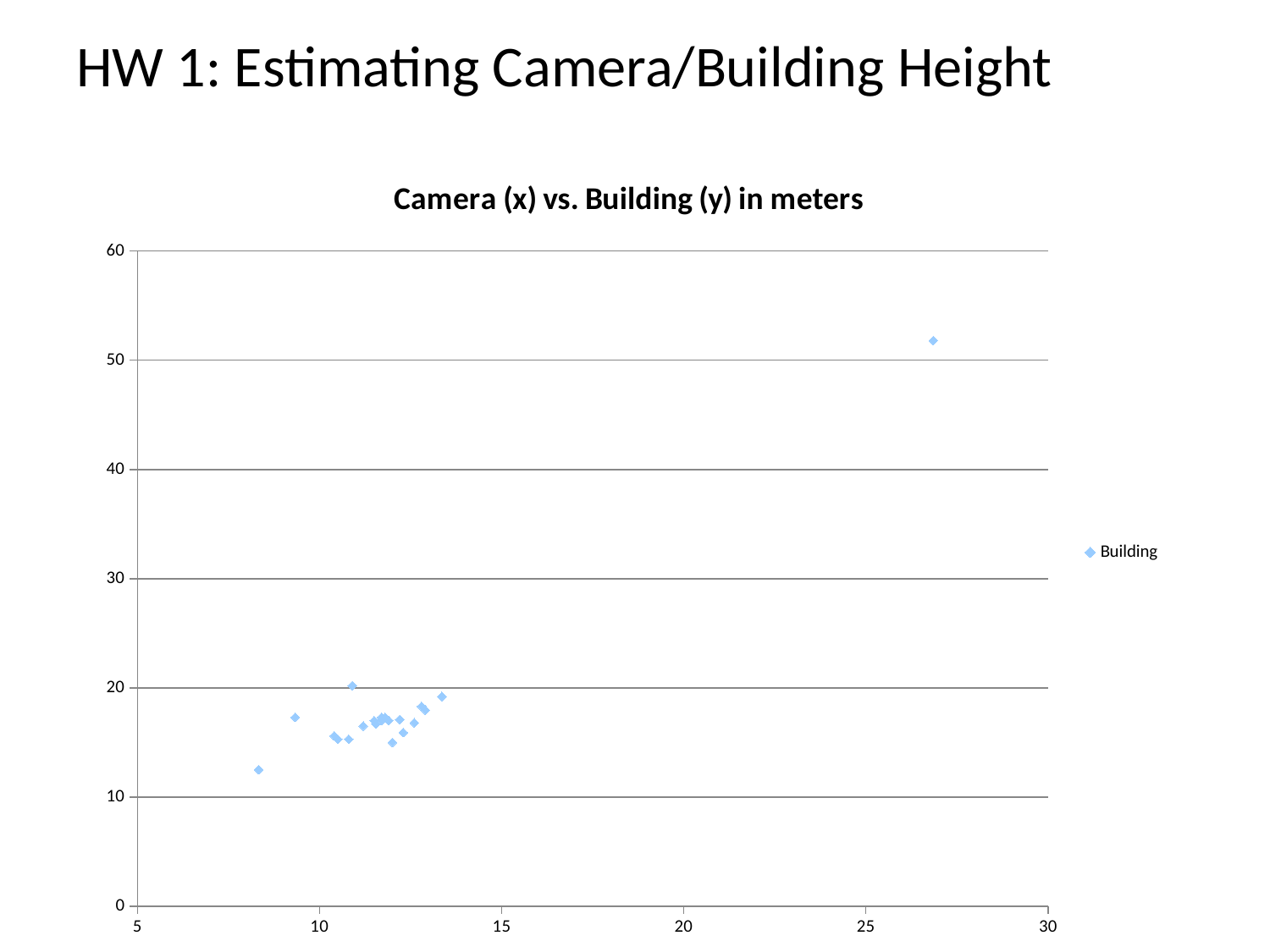
Do the y values generally rise or fall as x increases? rise Is the x value of the highest point greater or less than 25? greater How many series does the legend list? 1 Is the y value of the lowest point greater or less than 10? greater What is the maximum value shown on the y axis? 60 Which is larger: the y value of the point near x = 27 or the y value of the point near x = 8? the point near x = 27 What is the name of the series shown in the legend? Building What kind of chart is shown on the slide? scatter chart What is the title of the chart? Camera (x) vs. Building (y) in meters